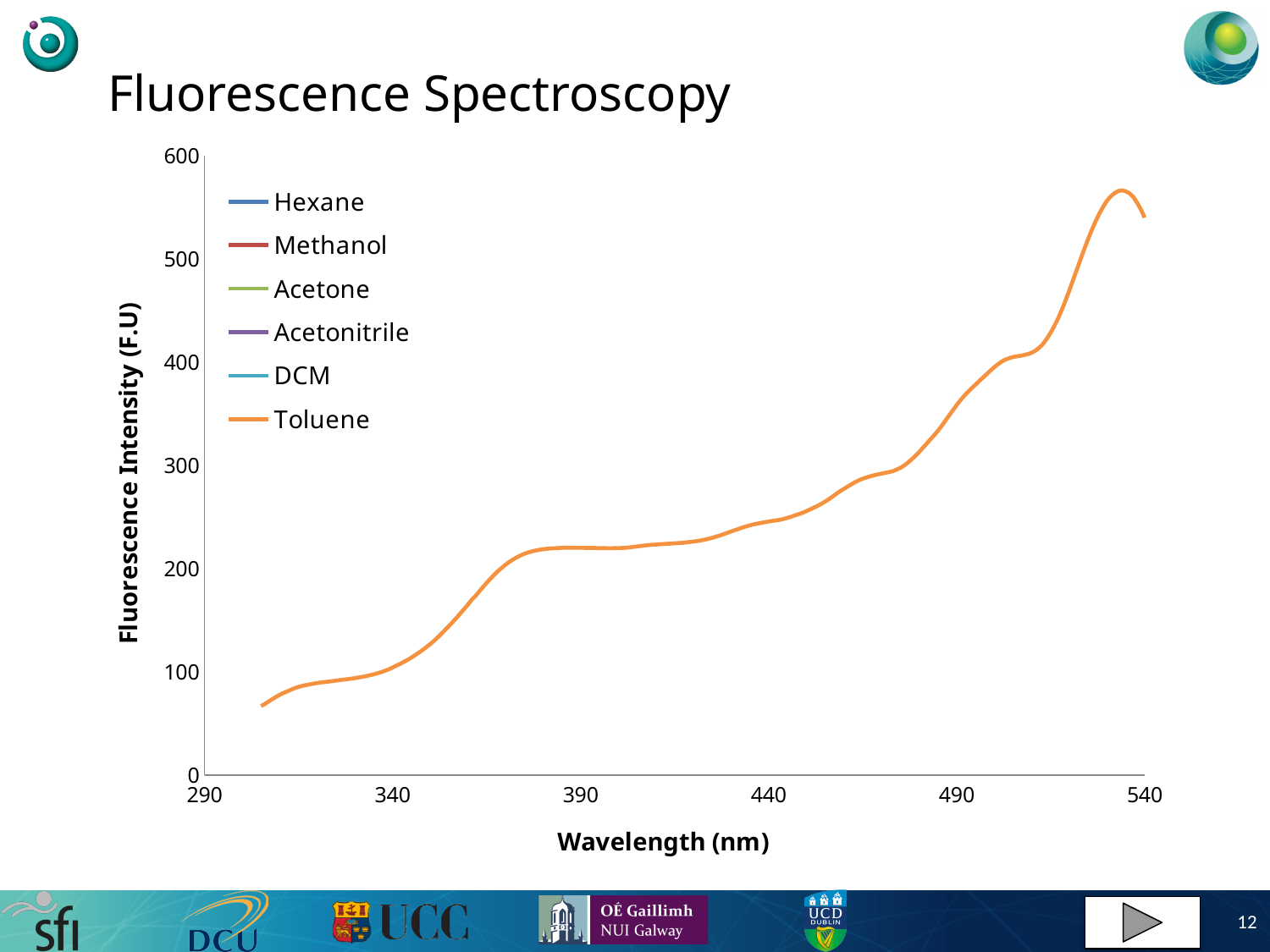
Is the highest point of the Toluene line greater or less than 500? greater What kind of chart is shown on the slide? line chart Does the Toluene line generally rise or fall as wavelength increases from 290 nm to 540 nm? rise Is the Toluene value at 440 nm greater or less than 300? less Is the Toluene value at 490 nm greater or less than 400? less How many series does the legend list? 6 What is the title of the chart's y axis? Fluorescence Intensity (F.U) Which series is drawn in orange? Toluene What is the title of the chart's x axis? Wavelength (nm)